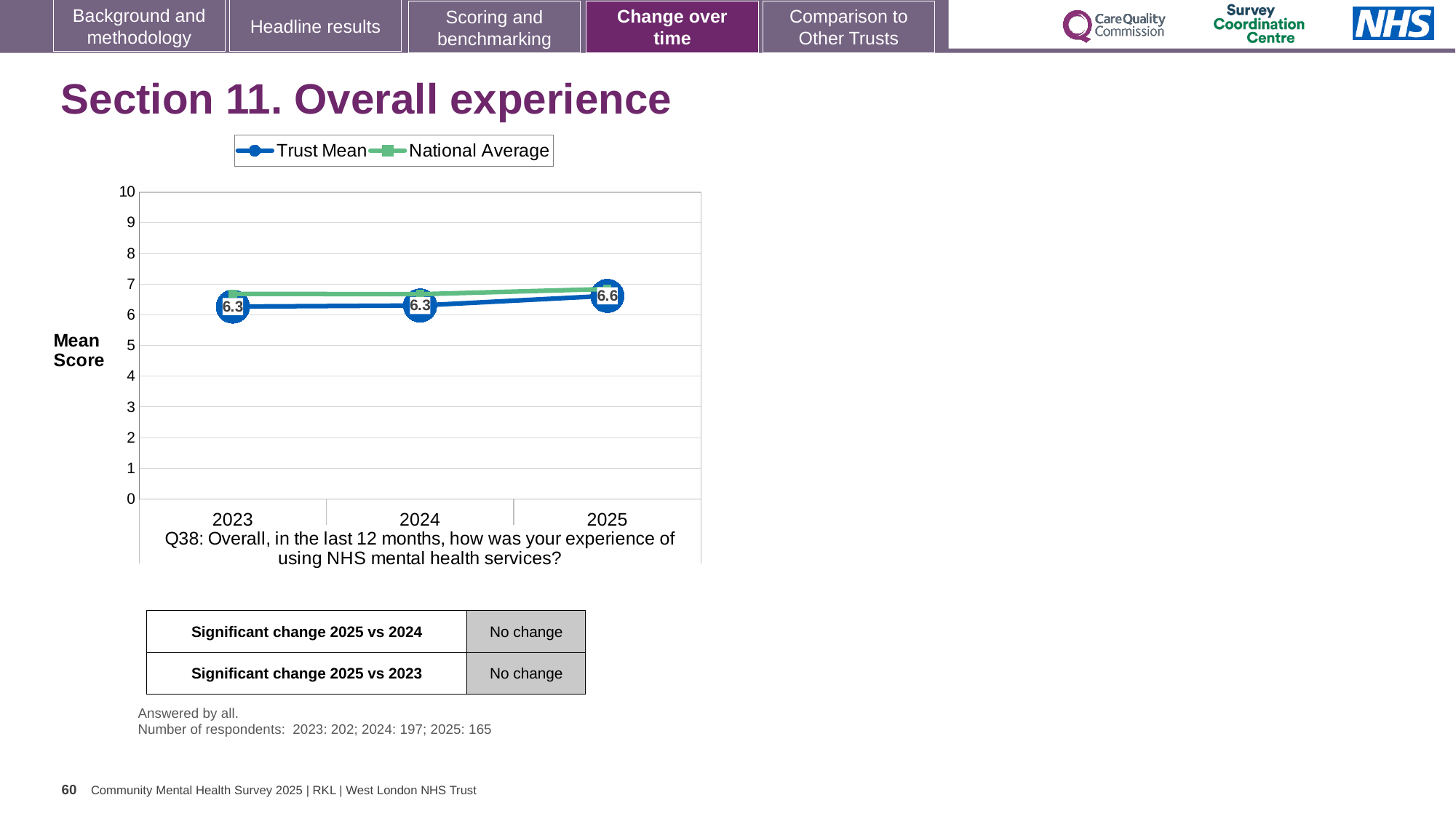
What is the difference between the Trust Mean in 2025 and in 2023? 0.3 What is the Trust Mean value for 2023? 6.3 How many years are shown on the x axis? 3 How many series does the legend list? 2 In which year is the Trust Mean highest? 2025 What is the label on the y axis? Mean Score What is the Trust Mean value for 2024? 6.3 What kind of chart is shown? line chart Is the National Average value for 2023 greater or less than 5? greater What is the Trust Mean value for 2025? 6.6 Does the Trust Mean rise or fall from 2024 to 2025? rise Which is larger, the Trust Mean for 2025 or for 2024? 2025